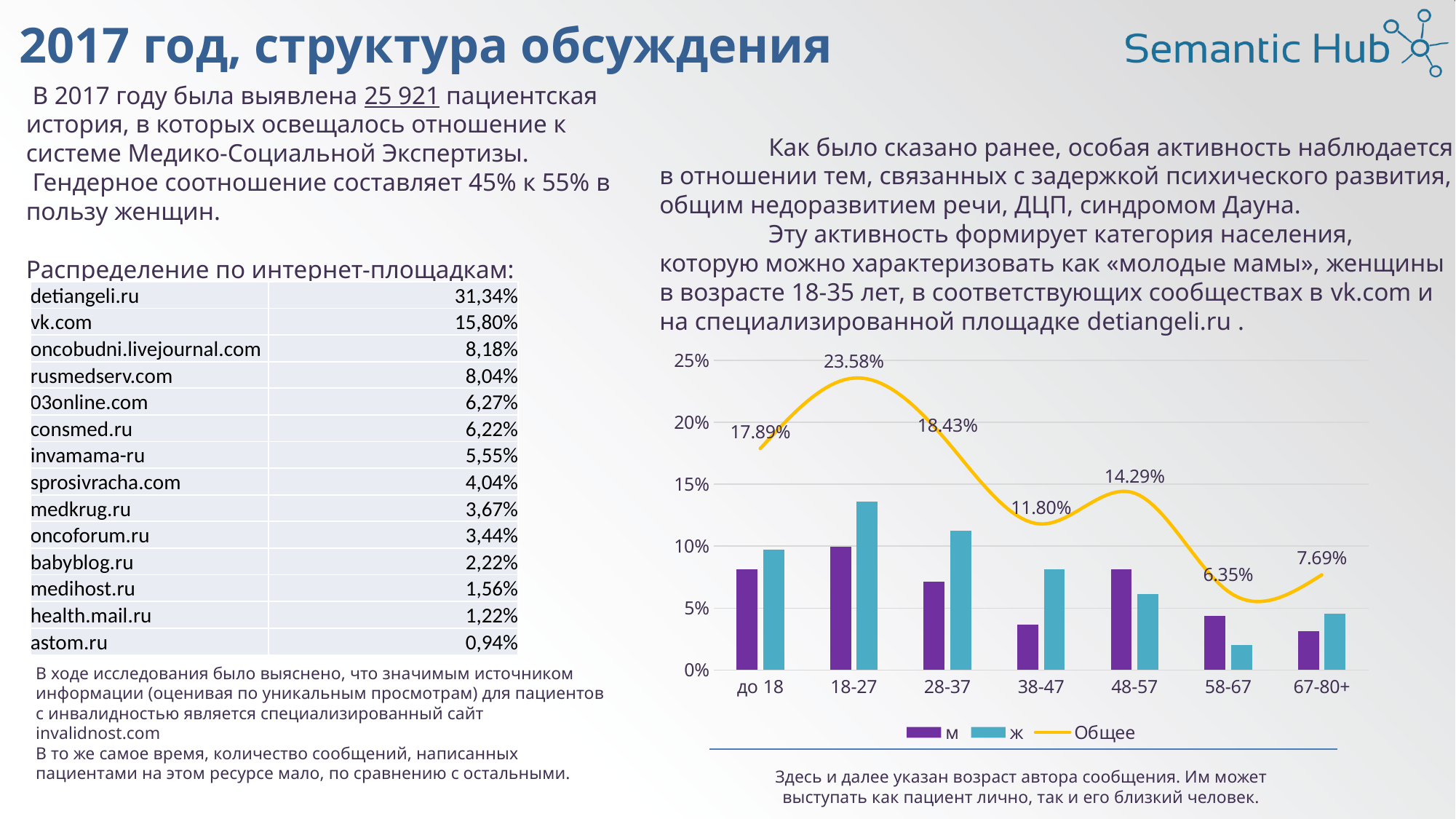
How many series does the chart legend list? 3 Which age group has the lowest value on the Общее line? 58-67 How many age groups are shown on the x axis of the chart? 7 Which is larger on the Общее line: the value for до 18 or for 28-37? 28-37 Is the ж bar for the 18-27 age group greater or less than 10%? greater What is the difference between the Общее values for 48-57 and 38-47? 2.49% Does the Общее line rise or fall from the 18-27 group to the 38-47 group? fall Is the м bar for the 38-47 age group greater or less than 5%? less What is the value of the Общее line for the 18-27 age group? 23.58% Which age group has the highest value on the Общее line? 18-27 What is the difference between the Общее values for 18-27 and 28-37? 5.15% What is the value of the Общее line for the 38-47 age group? 11.80%